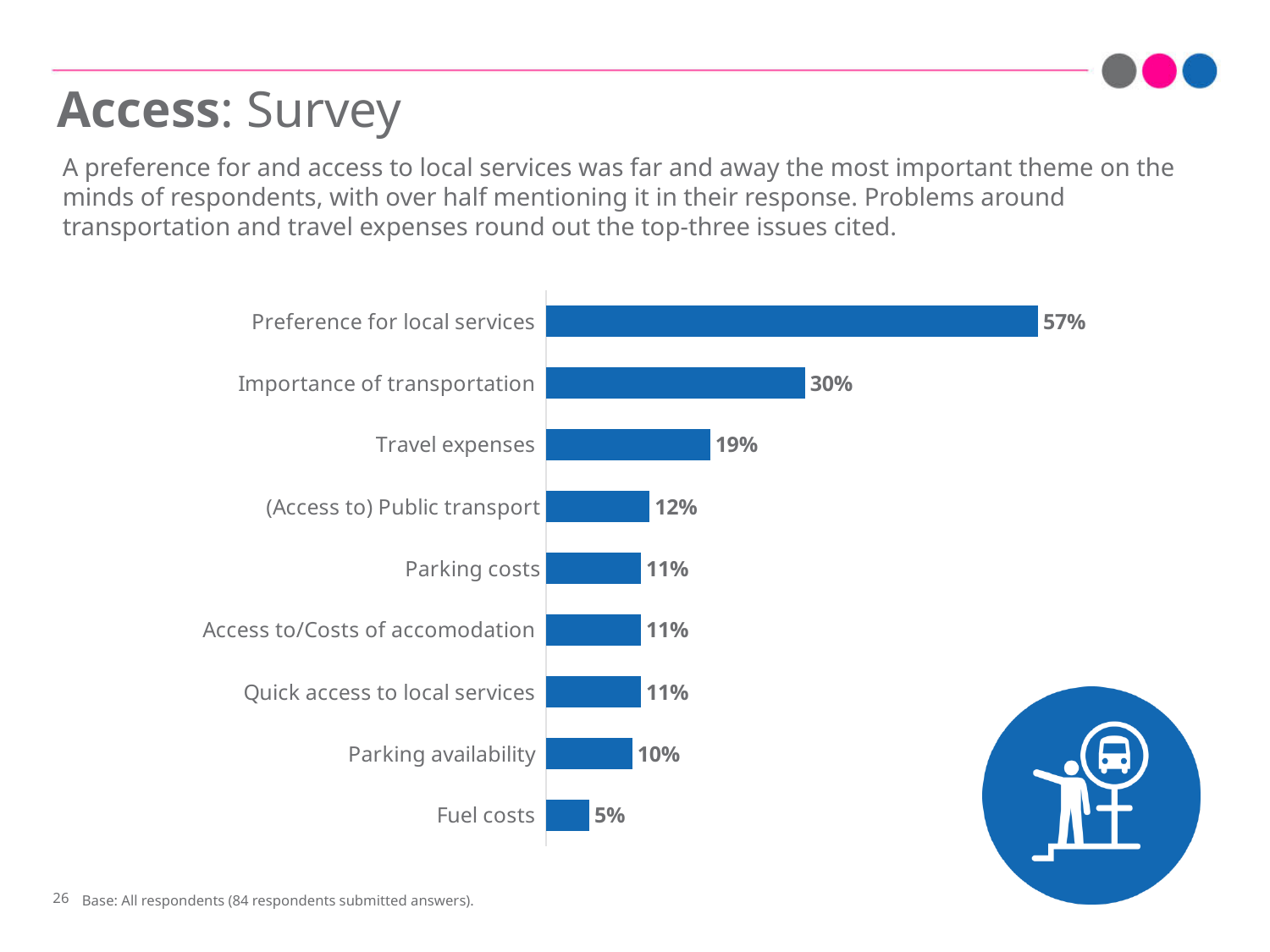
What is the difference between Travel expenses and (Access to) Public transport? 7% Which is larger, Importance of transportation or Travel expenses? Importance of transportation What is the value shown for Travel expenses? 19% What kind of chart is shown on the slide? Bar chart What percentage of respondents mentioned Preference for local services? 57% What is the value shown for Fuel costs? 5% How many categories share the value 11%? 3 What is the difference between Preference for local services and Importance of transportation? 27% What is the value shown for Parking availability? 10% Which category has the lowest value? Fuel costs How many categories are shown in the chart? 9 Which category has the highest value? Preference for local services